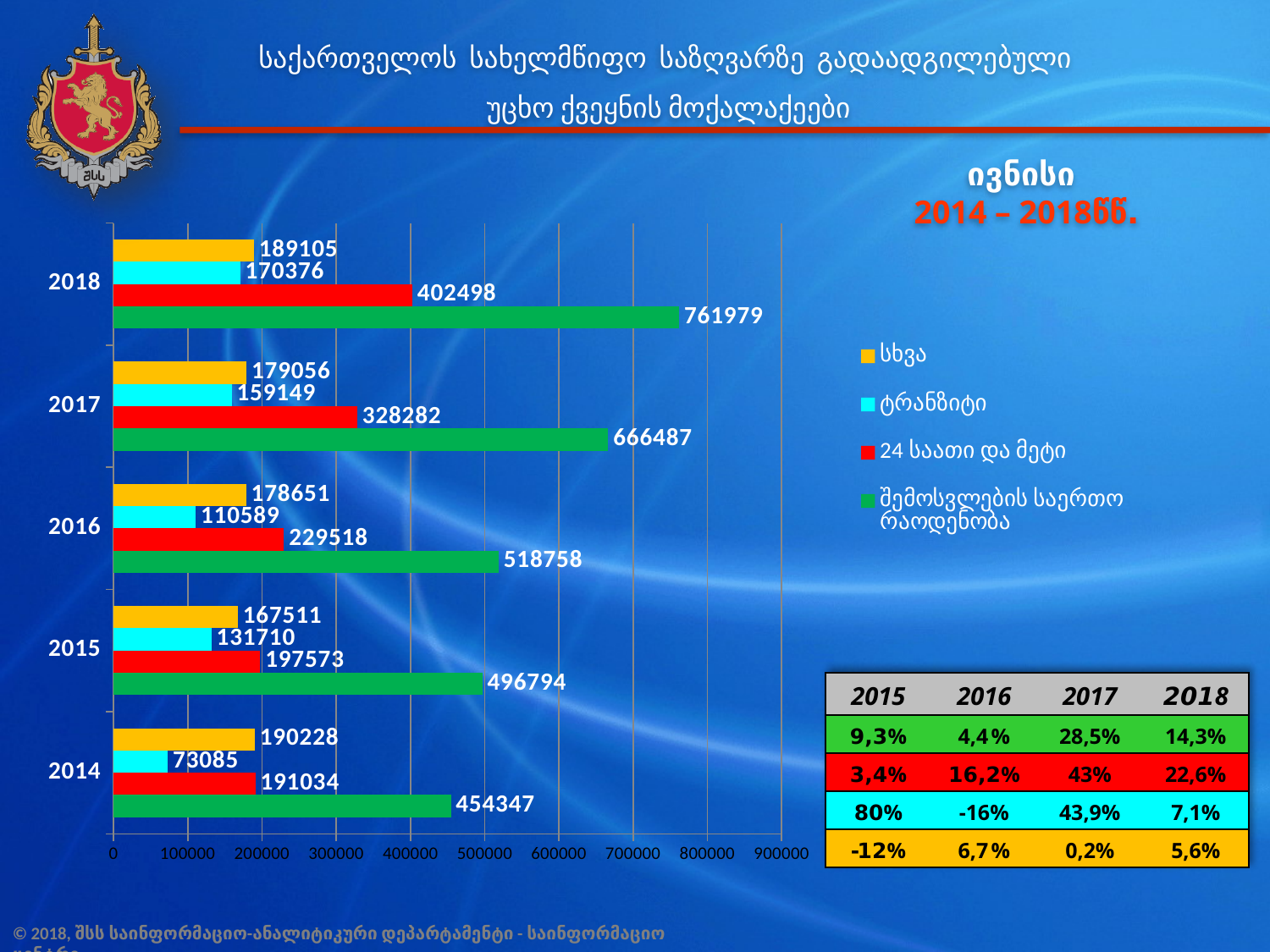
What is the value of the green series (შემოსვლების საერთო რაოდენობა) for 2018? 761979 What is the difference between the green series values for 2018 and 2017? 95492 How many years are shown on the chart? 5 What is the value of the yellow series (სხვა) for 2015? 167511 What is the value of the cyan series (ტრანზიტი) for 2014? 73085 What is the value of the red series (24 საათი და მეტი) for 2016? 229518 In which year is the green series (შემოსვლების საერთო რაოდენობა) highest? 2018 What type of chart is shown on the slide? bar chart Is the green series value for 2014 greater or less than 400000? greater Which is larger: the red series value for 2017 or the red series value for 2016? 2017 (328282) In which year is the cyan series (ტრანზიტი) lowest? 2014 How many series does the legend list? 4